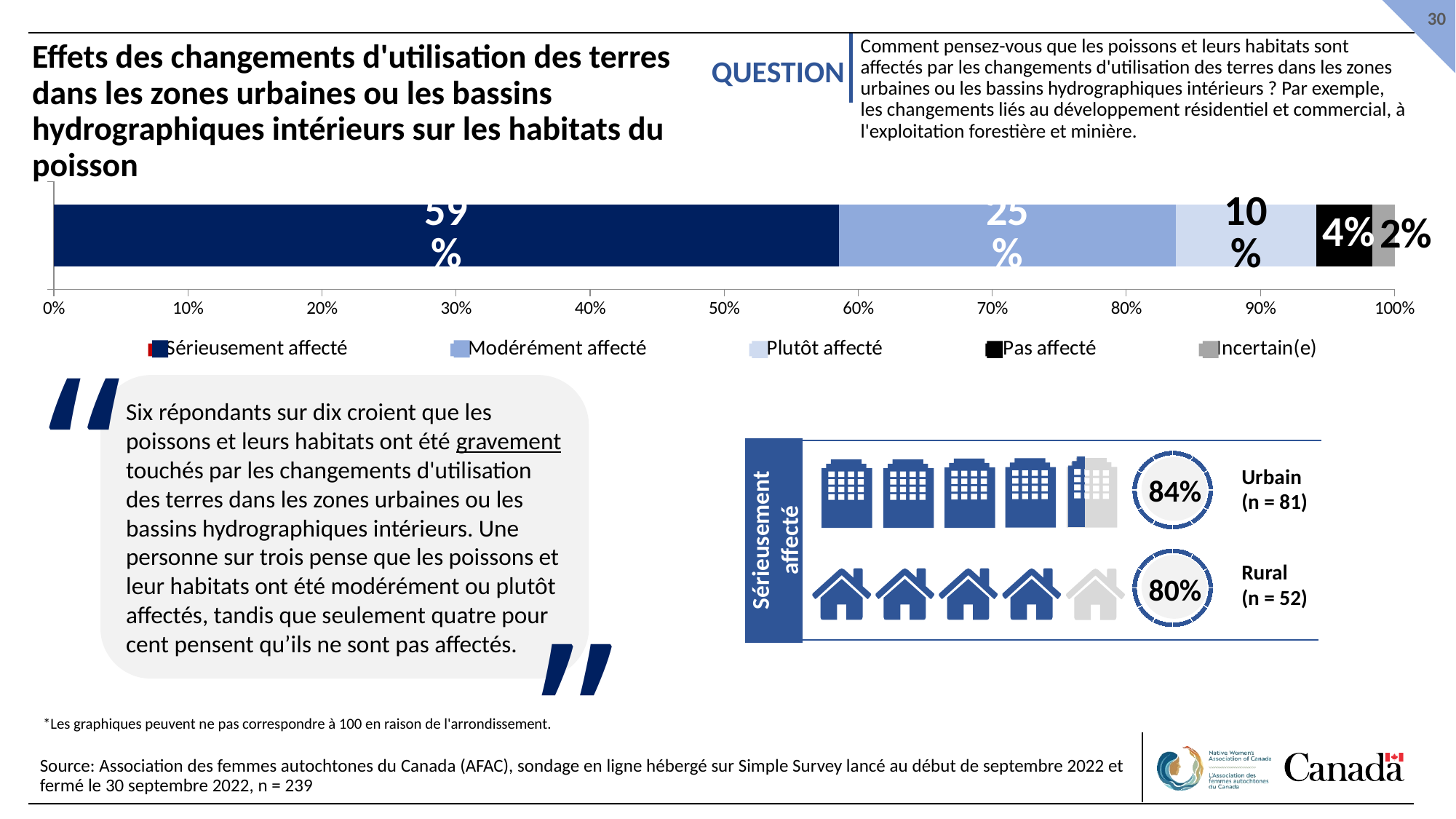
What percentage of respondents answered 'Plutôt affecté'? 10% What is the difference in percentage points between 'Sérieusement affecté' and 'Modérément affecté'? 34 What percentage of respondents answered 'Pas affecté'? 4% What percentage of respondents said fish habitats were 'Sérieusement affecté'? 59% In the infographic at the bottom right, what percentage of urban respondents (n = 81) said fish habitats were 'Sérieusement affecté'? 84% Which is larger: the share for 'Plutôt affecté' or the share for 'Pas affecté'? Plutôt affecté Which response category has the smallest share in the stacked bar? Incertain(e) What type of chart is used to show the distribution of responses at the top of the slide? Stacked bar chart What percentage of respondents answered 'Incertain(e)'? 2% What percentage of respondents answered 'Modérément affecté'? 25% Which response category has the largest share in the stacked bar? Sérieusement affecté How many response categories does the legend of the stacked bar chart list? 5